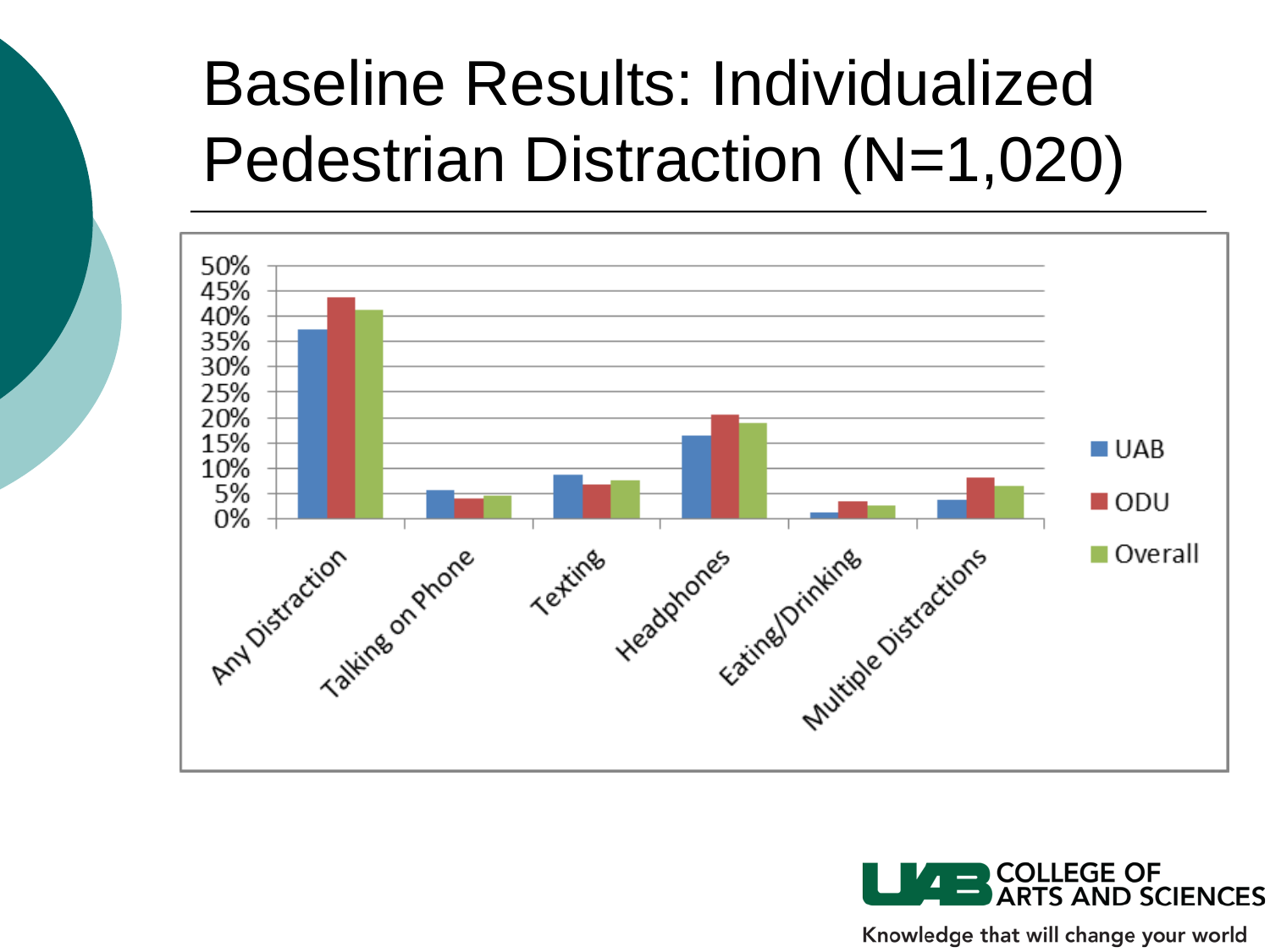
Which category has the lowest UAB value? Eating/Drinking For Texting, which is larger: the UAB value or the ODU value? UAB What kind of chart is shown on the slide? Bar chart Is the ODU value for Headphones greater or less than 15%? greater What are the three series named in the legend? UAB, ODU, Overall How many distraction categories are shown on the x axis? 6 Is the ODU value for Any Distraction greater or less than 40%? greater How many series does the legend list? 3 For Headphones, which is larger: the UAB value or the ODU value? ODU Is the Overall value for Eating/Drinking greater or less than 5%? less Which category has the highest ODU value? Any Distraction